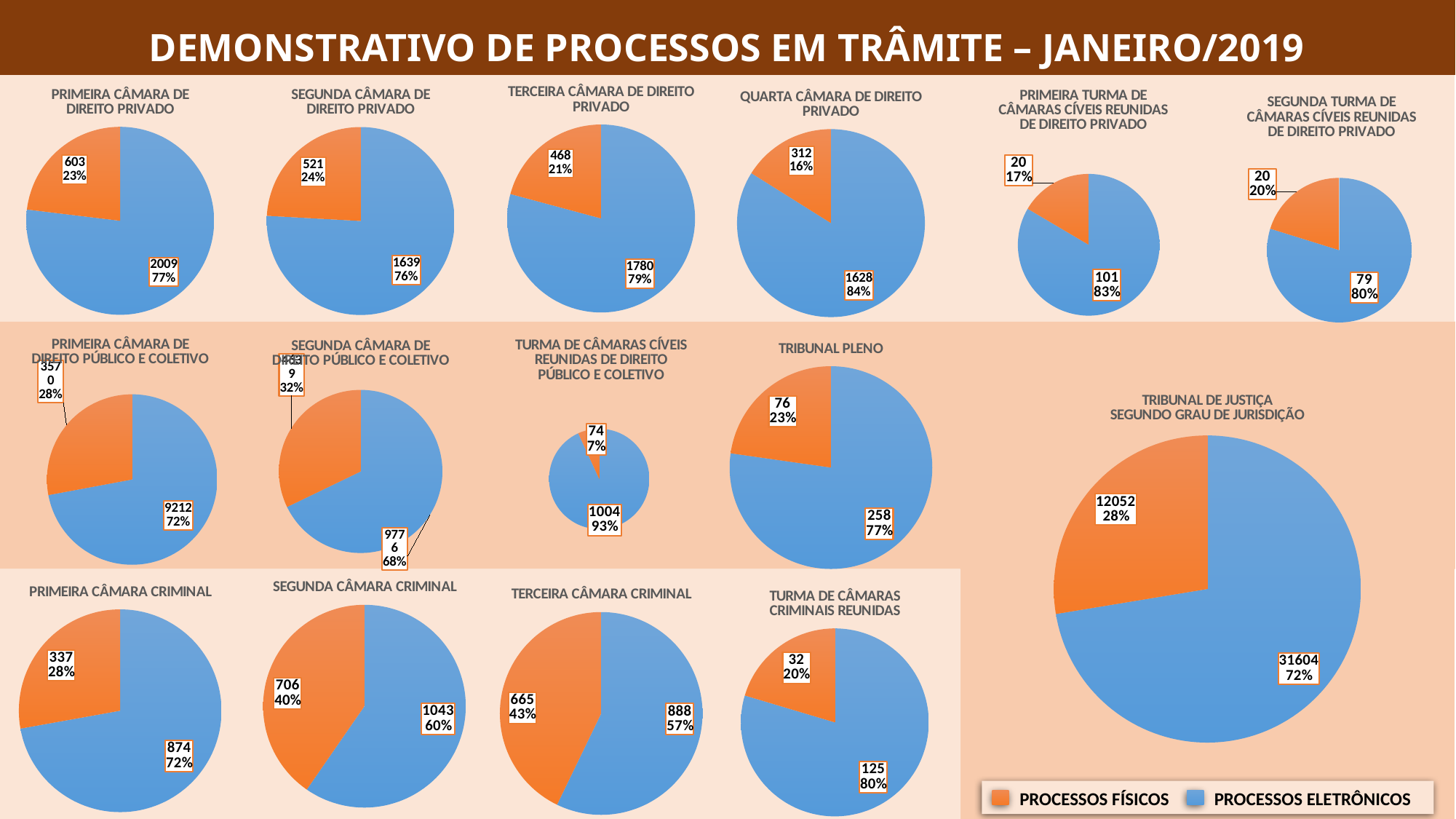
In the 'SEGUNDA CÂMARA CRIMINAL' chart, what is the difference between processos eletrônicos and processos físicos? 337 How many series does the legend list? 2 In the 'TRIBUNAL DE JUSTIÇA SEGUNDO GRAU DE JURISDIÇÃO' chart, what share of the pie is processos físicos? 28% In the 'TRIBUNAL PLENO' chart, what is the total of processos físicos and processos eletrônicos? 334 Which colour represents processos físicos in the legend? Orange What type of chart is used throughout the slide? Pie chart In the 'TURMA DE CÂMARAS CRIMINAIS REUNIDAS' chart, what is the value for processos físicos? 32 In the 'PRIMEIRA CÂMARA DE DIREITO PRIVADO' chart, how many processos eletrônicos are shown? 2009 In the 'TERCEIRA CÂMARA CRIMINAL' chart, what is the value for processos físicos? 665 In the 'TURMA DE CÂMARAS CÍVEIS REUNIDAS DE DIREITO PÚBLICO E COLETIVO' chart, what percentage is processos eletrônicos? 93% In the 'SEGUNDA TURMA DE CÂMARAS CÍVEIS REUNIDAS DE DIREITO PRIVADO' chart, what is the value for processos eletrônicos? 79 In the 'QUARTA CÂMARA DE DIREITO PRIVADO' chart, which slice is larger, processos físicos or processos eletrônicos? Processos eletrônicos